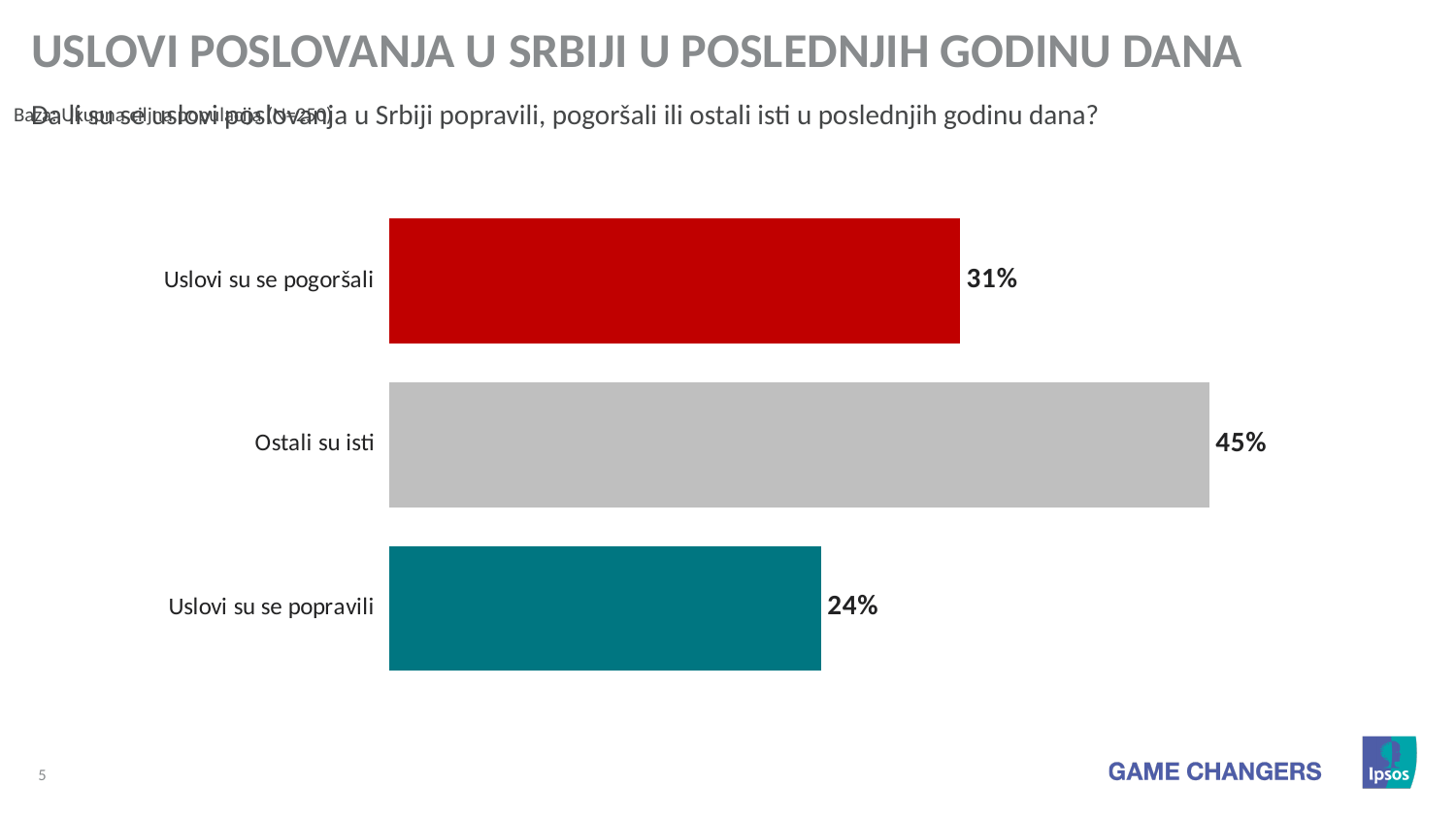
What is the value for "Ostali su isti"? 45% What is the difference between the values for "Uslovi su se pogoršali" and "Uslovi su se popravili"? 7% Which category has the highest value? Ostali su isti What is the title of the slide? USLOVI POSLOVANJA U SRBIJI U POSLEDNJIH GODINU DANA Which category has the lowest value? Uslovi su se popravili What colour is the bar for "Uslovi su se pogoršali"? Red How many categories are shown in the chart? 3 What is the value for "Uslovi su se popravili"? 24% What is the difference between the values for "Ostali su isti" and "Uslovi su se pogoršali"? 14% What kind of chart is shown on the slide? Bar chart What is the value for "Uslovi su se pogoršali"? 31% Which is larger, the value for "Uslovi su se pogoršali" or the value for "Uslovi su se popravili"? Uslovi su se pogoršali